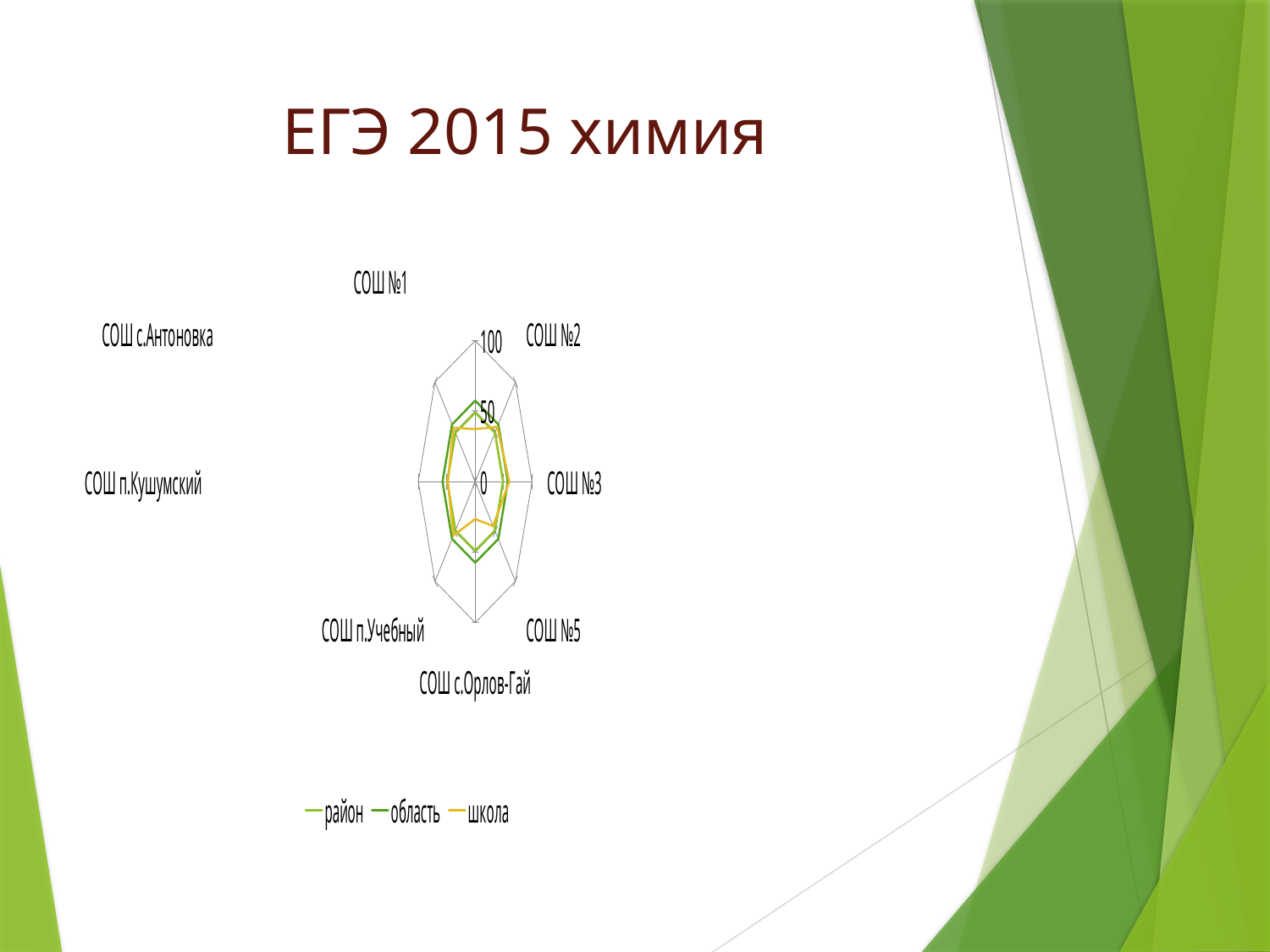
What kind of chart is shown on the slide? radar chart Is the value of the район series for СОШ №1 greater or less than 100? less How many series does the legend list? 3 What is the maximum value shown on the radar chart's axis? 100 What are the three series named in the legend? район, область, школа How many categories (schools) are plotted on the radar chart? 8 Is the value of the область series for СОШ №3 greater or less than 100? less Is the value of the школа series for СОШ с.Орлов-Гай greater or less than 50? less What is the title of the slide containing the chart? ЕГЭ 2015 химия